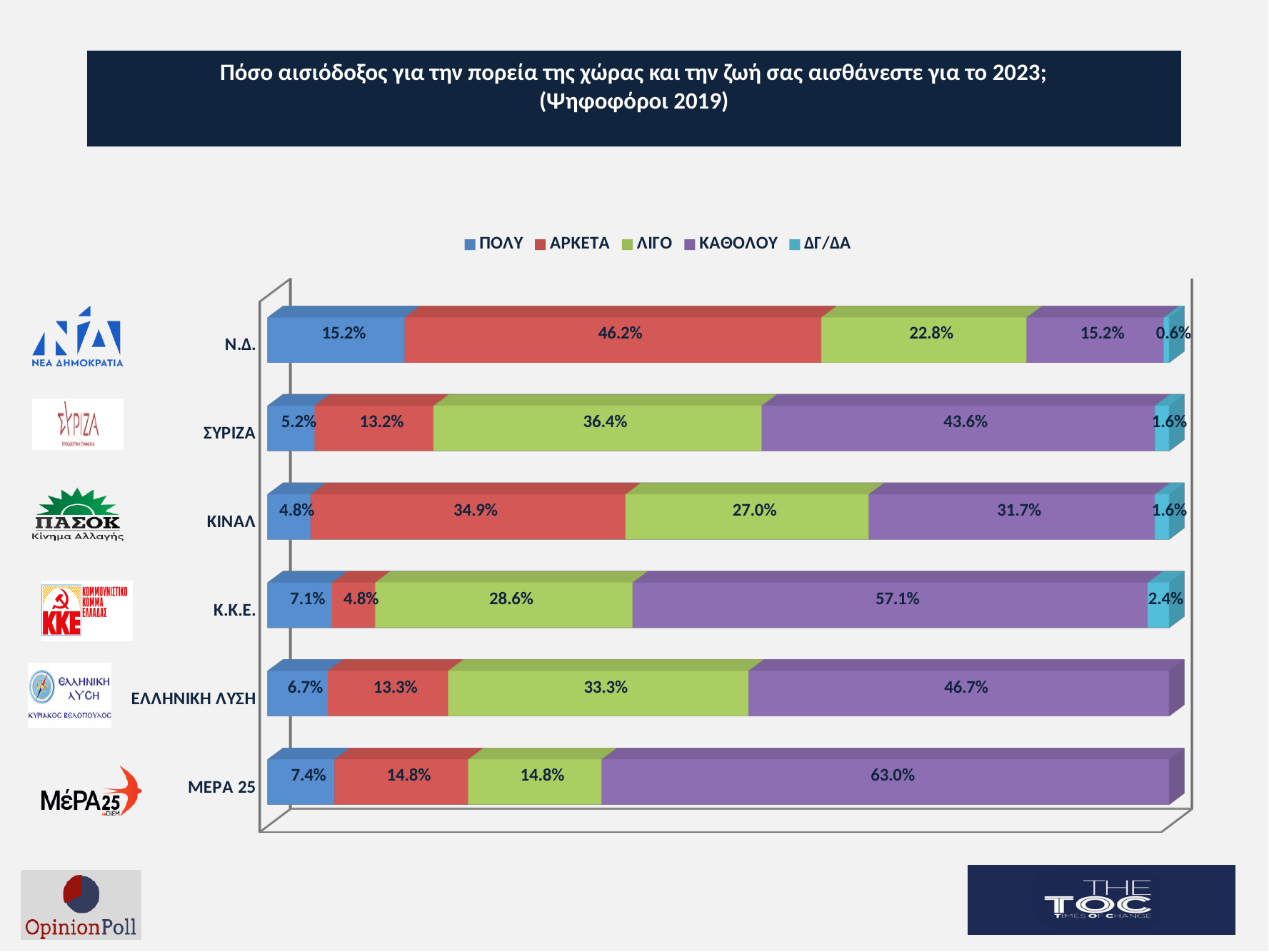
Which party has the lowest ΠΟΛΥ value? ΚΙΝΑΛ What is the ΚΑΘΟΛΟΥ value for Κ.Κ.Ε.? 57.1% Which is larger: the ΛΙΓΟ value for ΕΛΛΗΝΙΚΗ ΛΥΣΗ or the ΛΙΓΟ value for ΚΙΝΑΛ? ΕΛΛΗΝΙΚΗ ΛΥΣΗ What is the ΛΙΓΟ value for ΣΥΡΙΖΑ? 36.4% How many parties are shown on the chart? 6 How many series does the legend list? 5 What is the difference between the ΑΡΚΕΤΑ value for Ν.Δ. and the ΑΡΚΕΤΑ value for ΣΥΡΙΖΑ? 33.0% What is the ΔΓ/ΔΑ value for ΚΙΝΑΛ? 1.6% What kind of chart is shown on the slide? Stacked bar chart Which colour represents ΚΑΘΟΛΟΥ in the legend? Purple Which party has the highest ΚΑΘΟΛΟΥ value? ΜΕΡΑ 25 What percentage of Ν.Δ. voters answered ΑΡΚΕΤΑ? 46.2%